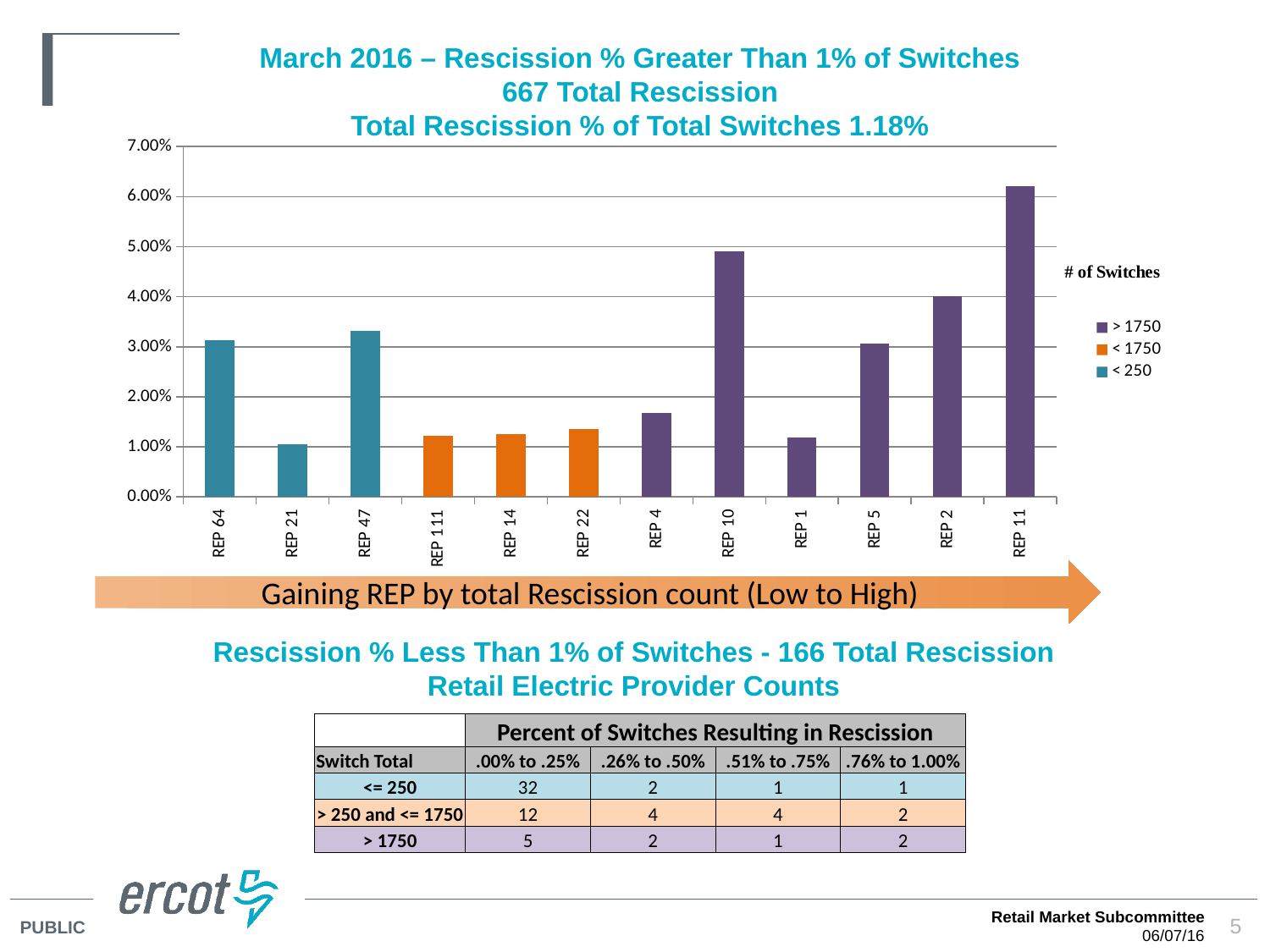
How many series does the chart legend list? 3 Is the value for REP 5 greater or less than 4.00%? less Is the value for REP 11 greater or less than 5.00%? greater What kind of chart is shown on the slide? bar chart Is the value for REP 64 greater or less than 2.00%? greater Which REP has the highest rescission percentage in the chart? REP 11 What is the title of the chart legend? # of Switches Which has a higher rescission percentage, REP 47 or REP 21? REP 47 How many REPs are plotted on the x axis of the chart? 12 Which has a higher rescission percentage, REP 10 or REP 2? REP 10